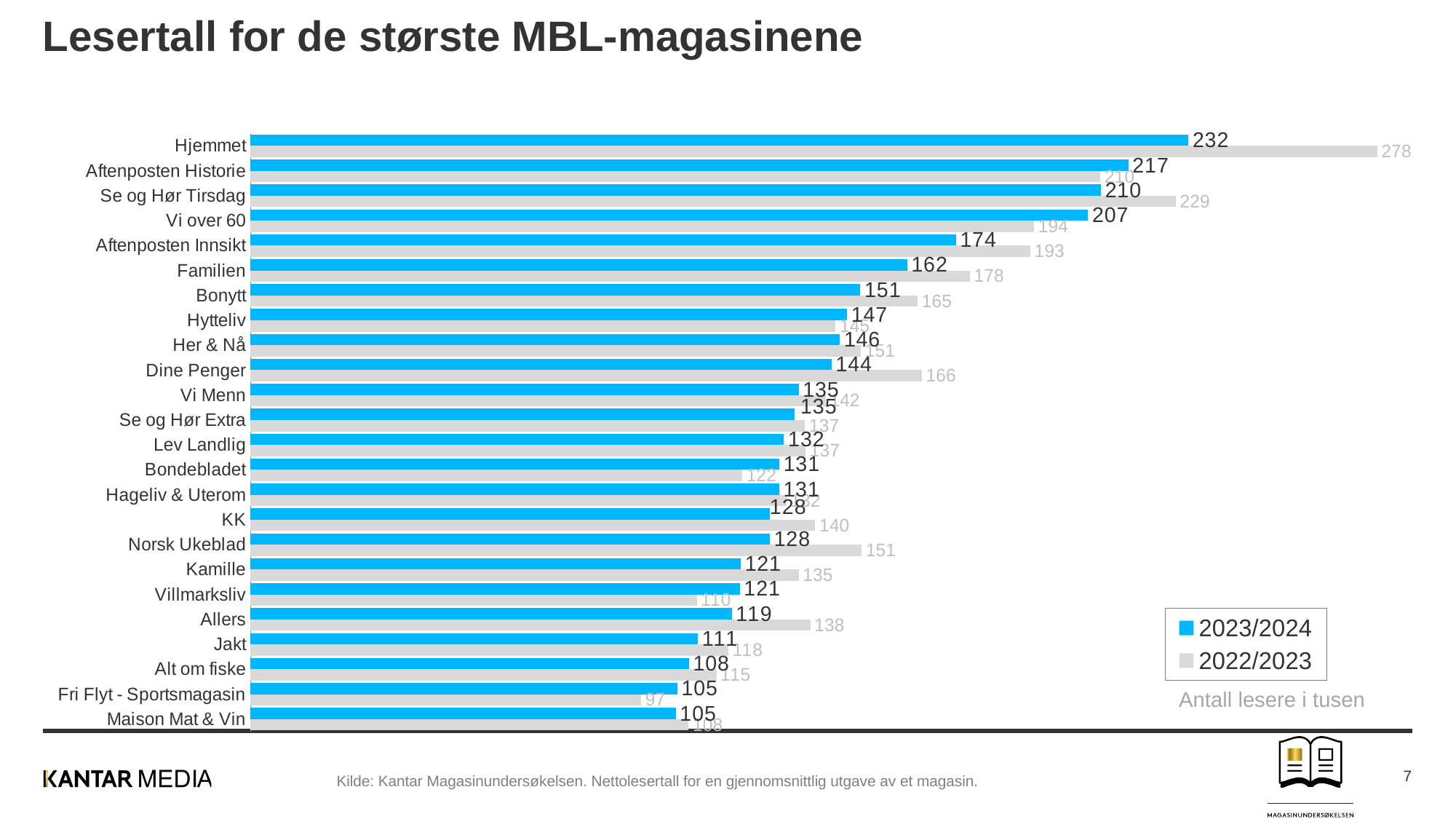
How many series does the legend list? 2 What type of chart is shown on the slide? Bar chart What is the difference between the 2022/2023 and 2023/2024 values for Hjemmet? 46 How many magazines are shown in the chart? 24 Which magazine has the highest 2022/2023 value? Hjemmet For Vi over 60, which is larger: the 2023/2024 value or the 2022/2023 value? 2023/2024 What unit note is shown below the legend? Antall lesere i tusen What is the 2023/2024 value for Hjemmet? 232 Which magazine has the lowest 2022/2023 value? Fri Flyt - Sportsmagasin What is the 2023/2024 value for Aftenposten Innsikt? 174 What is the 2022/2023 value for Dine Penger? 166 What is the difference between the 2022/2023 and 2023/2024 values for Norsk Ukeblad? 23